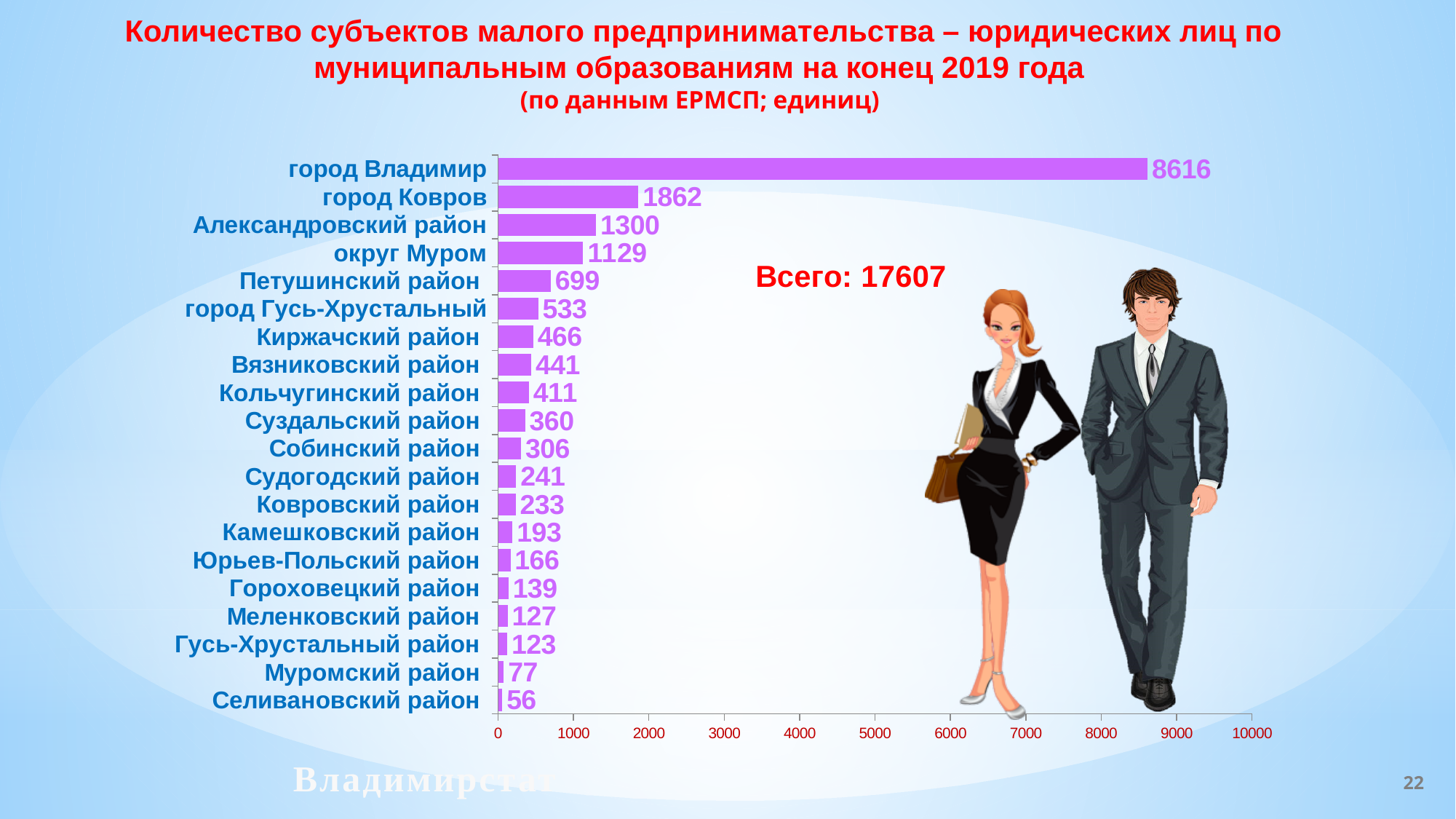
What kind of chart is shown on the slide? bar chart What is the value for Гусь-Хрустальный район? 123 What is the difference between the values for Муромский район and Селивановский район? 21 What total (Всего) is printed on the slide? 17607 Which category has the lowest value? Селивановский район Which category has the highest value? город Владимир Is the value for город Владимир greater or less than 8000? greater What is the value for город Владимир? 8616 Which is larger, the value for округ Муром or the value for город Гусь-Хрустальный? округ Муром What is the difference between the values for город Ковров and Александровский район? 562 How many categories are shown in the chart? 20 What is the value for Петушинский район? 699